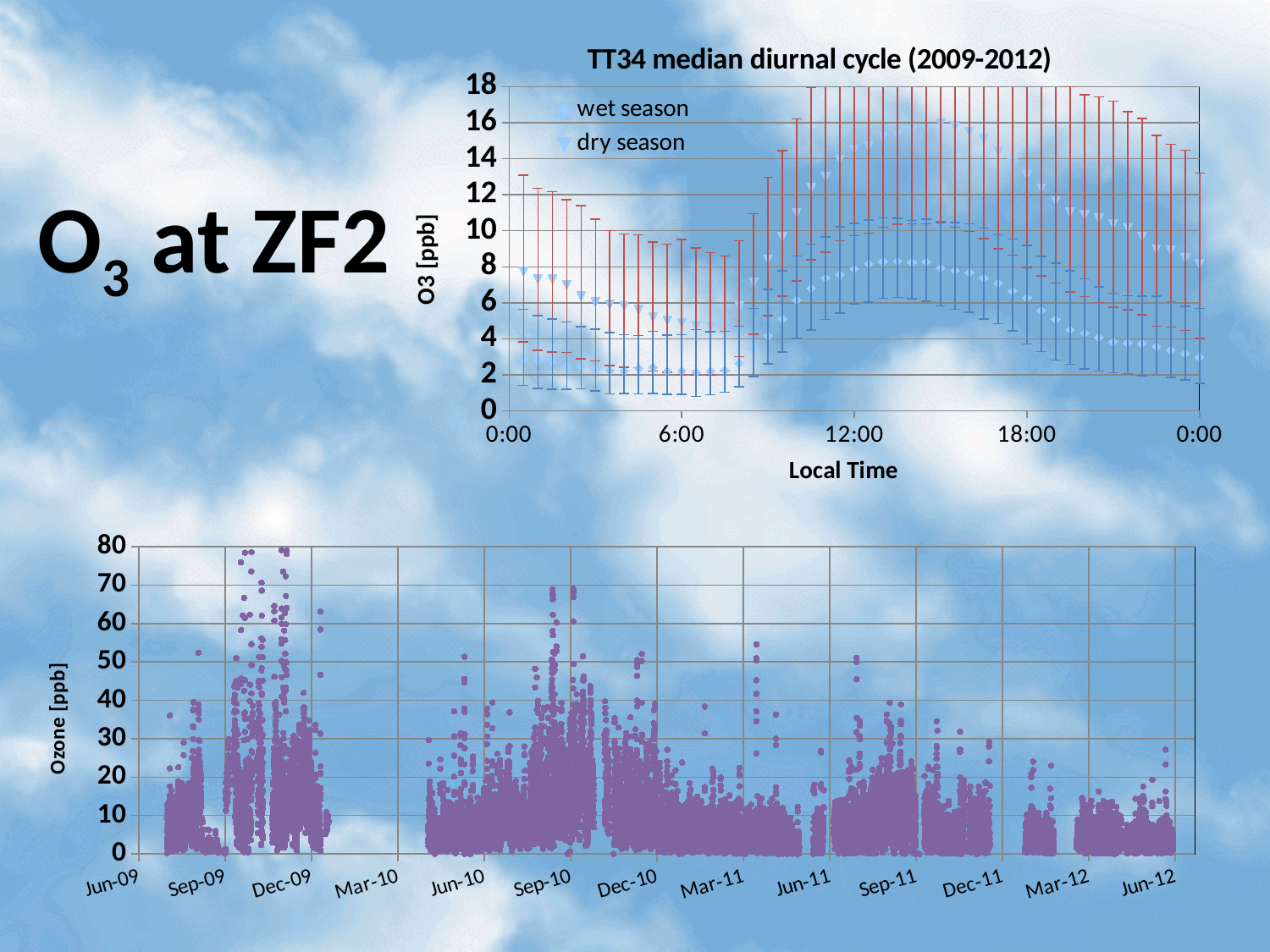
In the top chart, which series has the larger value at 12:00, wet season or dry season? dry season In the top chart, is the wet season value at 6:00 greater or less than 4? less In the bottom chart, are the highest ozone values around Dec-09 greater or less than 70? greater In the top chart, does the dry season series rise or fall between 6:00 and 12:00? rise In the top chart, is the dry season value at 12:00 greater or less than 10? greater In the top chart, does the wet season series rise or fall between 0:00 and 6:00? fall What is the title of the top chart? TT34 median diurnal cycle (2009-2012) In the top chart, how many series does the legend list? 2 In the top chart, what are the two series named in the legend? wet season and dry season What kind of chart is the bottom chart? scatter chart